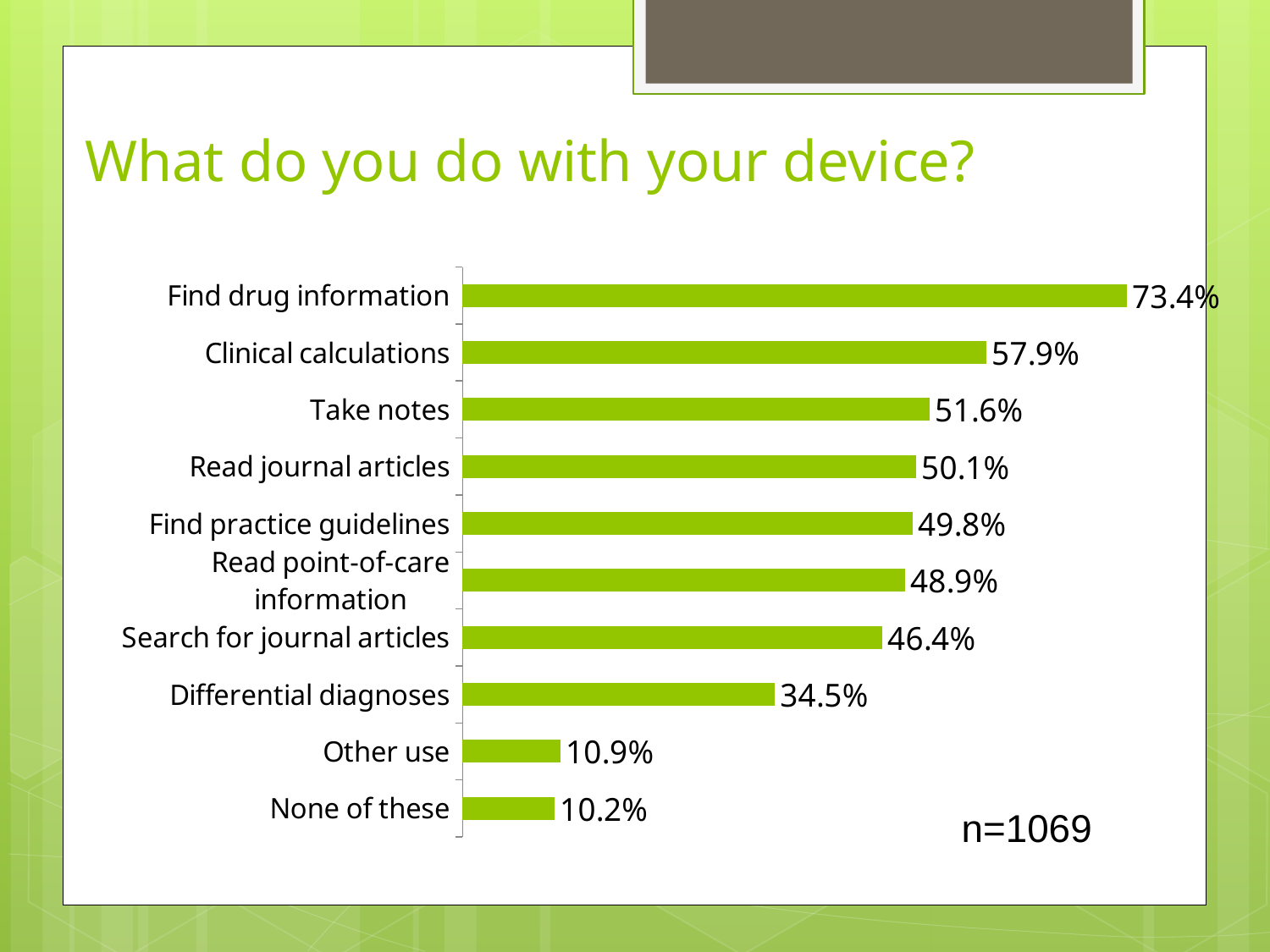
What is the difference in percentage points between Find drug information and Clinical calculations? 15.5 What sample size (n) is shown on the slide? n=1069 What is the value for Clinical calculations? 57.9% How many categories are shown in the chart? 10 What type of chart is shown on the slide? Bar chart Which activity has the highest percentage? Find drug information What percentage of respondents use their device to find drug information? 73.4% What percentage is shown for Differential diagnoses? 34.5% What is the difference in percentage points between Other use and None of these? 0.7 Which is larger, the value for Take notes or the value for Search for journal articles? Take notes Which category has the lowest percentage? None of these What is the title of the slide? What do you do with your device?